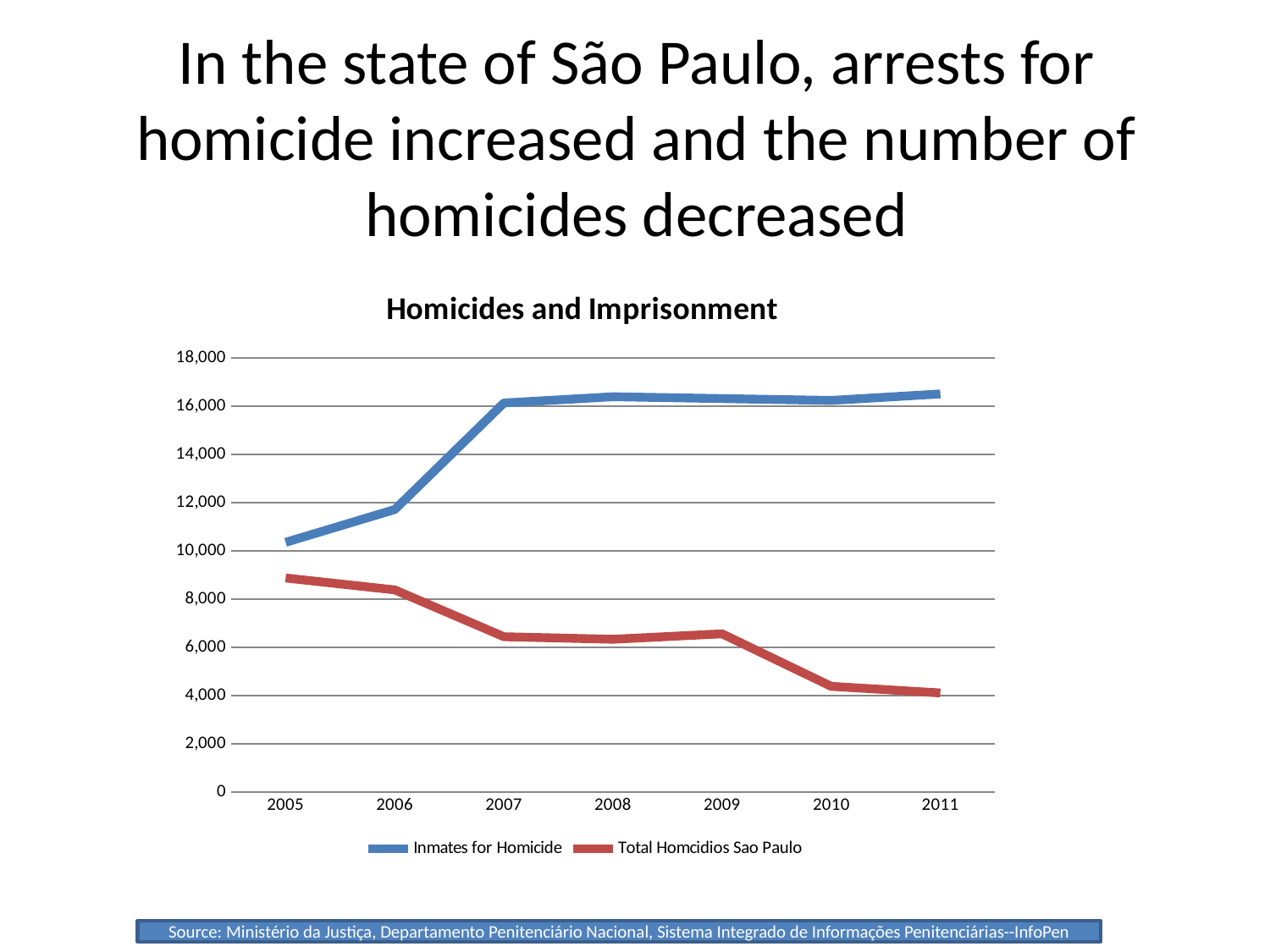
How many years are plotted along the x axis? 7 Does the Total Homcidios Sao Paulo series rise or fall from 2005 to 2011? fall In which year is the Inmates for Homicide value lowest? 2005 In which year is the Total Homcidios Sao Paulo value highest? 2005 Does the Inmates for Homicide series rise or fall from 2005 to 2011? rise What is the title of the chart? Homicides and Imprisonment What type of chart is shown on the slide? line chart Is the value for Total Homcidios Sao Paulo in 2005 greater or less than 8,000? greater How many series does the legend list? 2 Is the value for Inmates for Homicide in 2006 greater or less than 12,000? less In 2005, which is larger: Inmates for Homicide or Total Homcidios Sao Paulo? Inmates for Homicide Is the value for Total Homcidios Sao Paulo in 2009 greater or less than 8,000? less